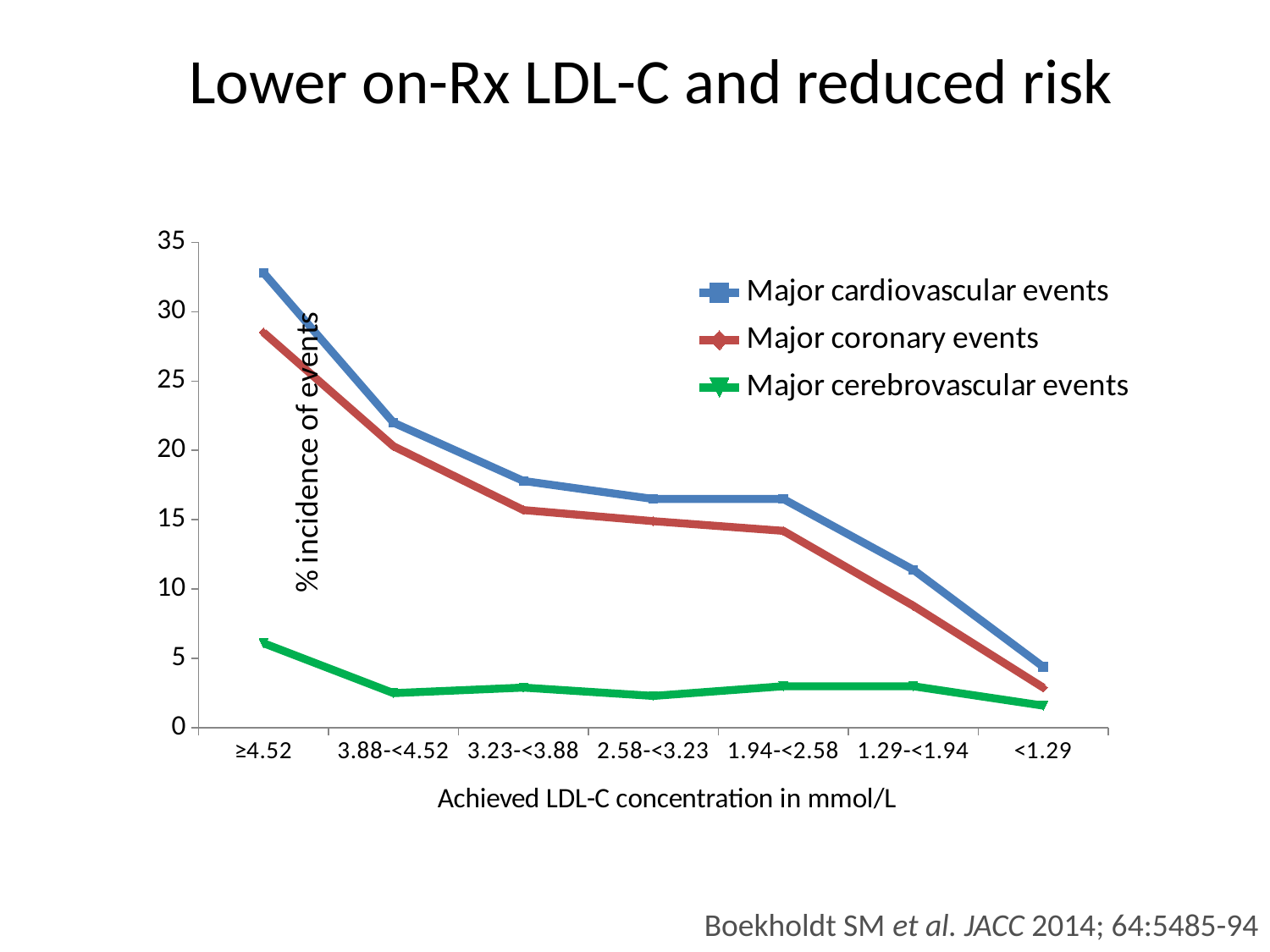
Is the value for Major coronary events at ≥4.52 greater or less than 30? less At ≥4.52, which is larger: Major cardiovascular events or Major coronary events? Major cardiovascular events Is the value for Major cardiovascular events at ≥4.52 greater or less than 30? greater What kind of chart is shown on the slide? Line chart How many series does the legend list? 3 Is the value for Major cardiovascular events at 3.88-<4.52 greater or less than 20? greater Do the values for Major cardiovascular events rise or fall from left to right along the x axis? fall How many LDL-C concentration categories are shown on the x axis? 7 Which LDL-C category has the highest value for Major cardiovascular events? ≥4.52 Which series has the lowest values across all LDL-C categories? Major cerebrovascular events